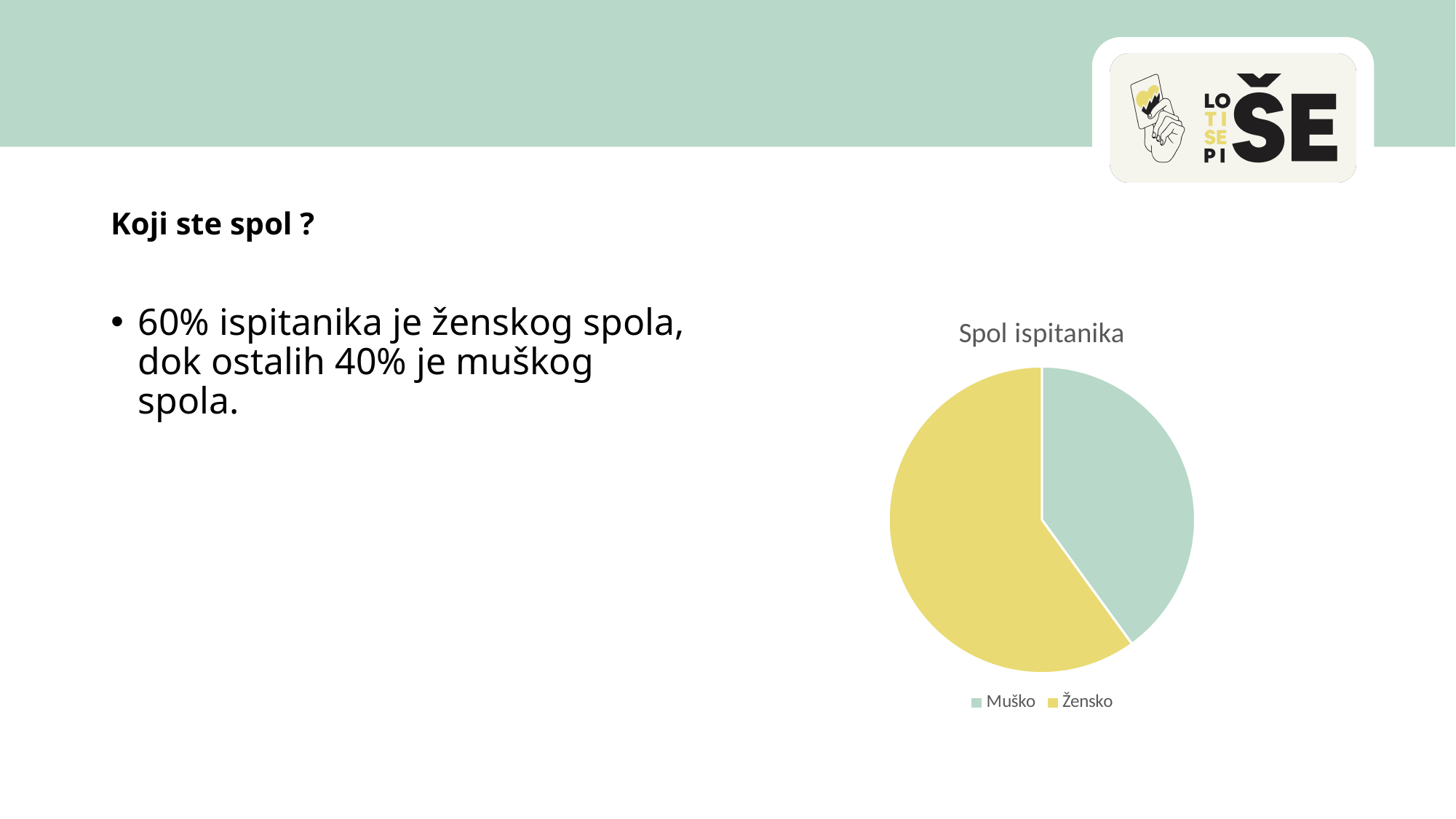
How many slices does the pie chart have? 2 Which slice of the pie chart is the smallest? Muško What kind of chart is shown on the slide? pie chart What colour is the Muško slice in the pie chart? green How many entries does the chart legend list? 2 Is the Žensko slice greater or less than half of the pie? greater What share of the pie does the Žensko slice represent? 60% Which slice of the pie chart is the largest? Žensko Which slice is larger, Muško or Žensko? Žensko What is the title of the chart? Spol ispitanika What share of the pie does the Muško slice represent? 40%